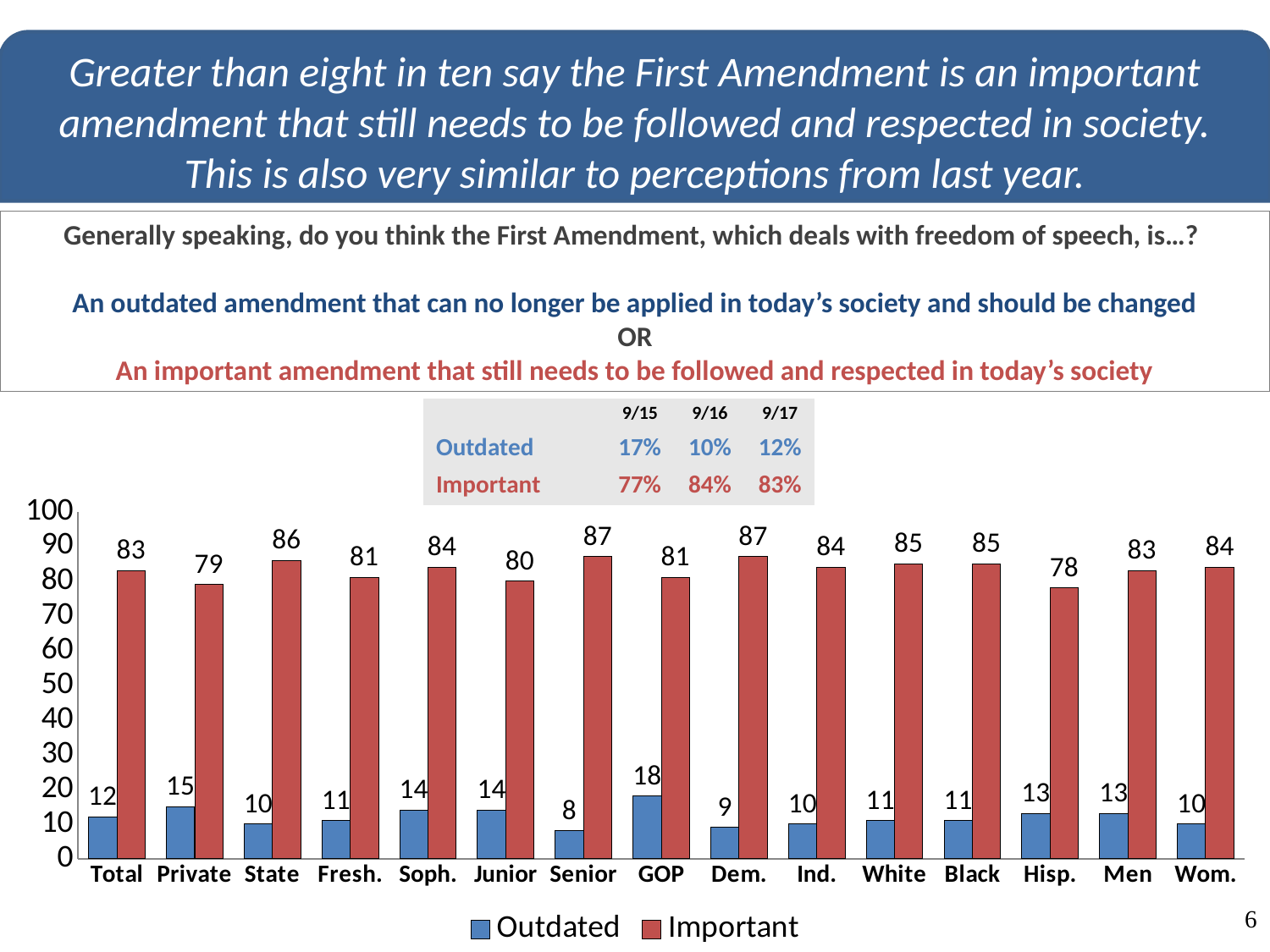
What colour are the Important bars in the chart? Red What is the value for Important among Seniors? 87 How many categories are shown on the x axis of the chart? 15 Which is larger, the Outdated value for Private or the Outdated value for Wom.? Private Which category has the lowest Important value? Hisp. What is the value for Important for the Total group? 83 Which category has the highest Outdated value? GOP Which category has the lowest Outdated value? Senior What is the value for Outdated among GOP respondents? 18 How many series does the chart legend list? 2 What kind of chart is shown on the slide? Bar chart What is the difference between the Important values for State and Private? 7